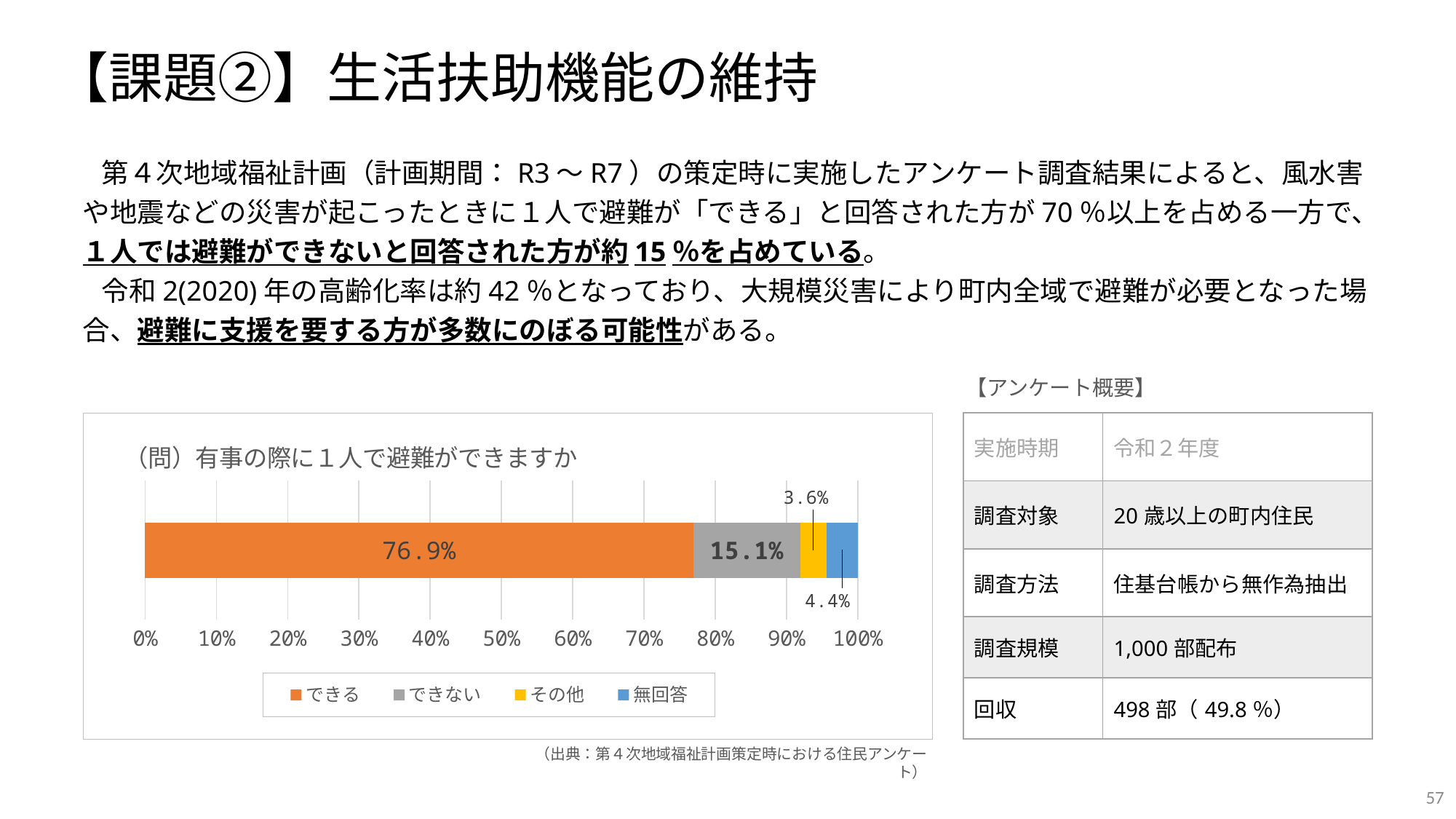
What is the value shown for 無回答? 4.4% What kind of chart is shown on the slide? Stacked bar chart Which response category has the smallest share? その他 What percentage of respondents answered できない? 15.1% How many series does the legend list? 4 What percentage of respondents answered できる (can evacuate alone)? 76.9% Is the value for できる greater or less than 70%? greater What is the difference between the できる and できない percentages? 61.8% Which is larger, the share for 無回答 or the share for その他? 無回答 What is the value shown for その他? 3.6% What colour is used for the できる segment of the bar? Orange Which response category has the largest share? できる